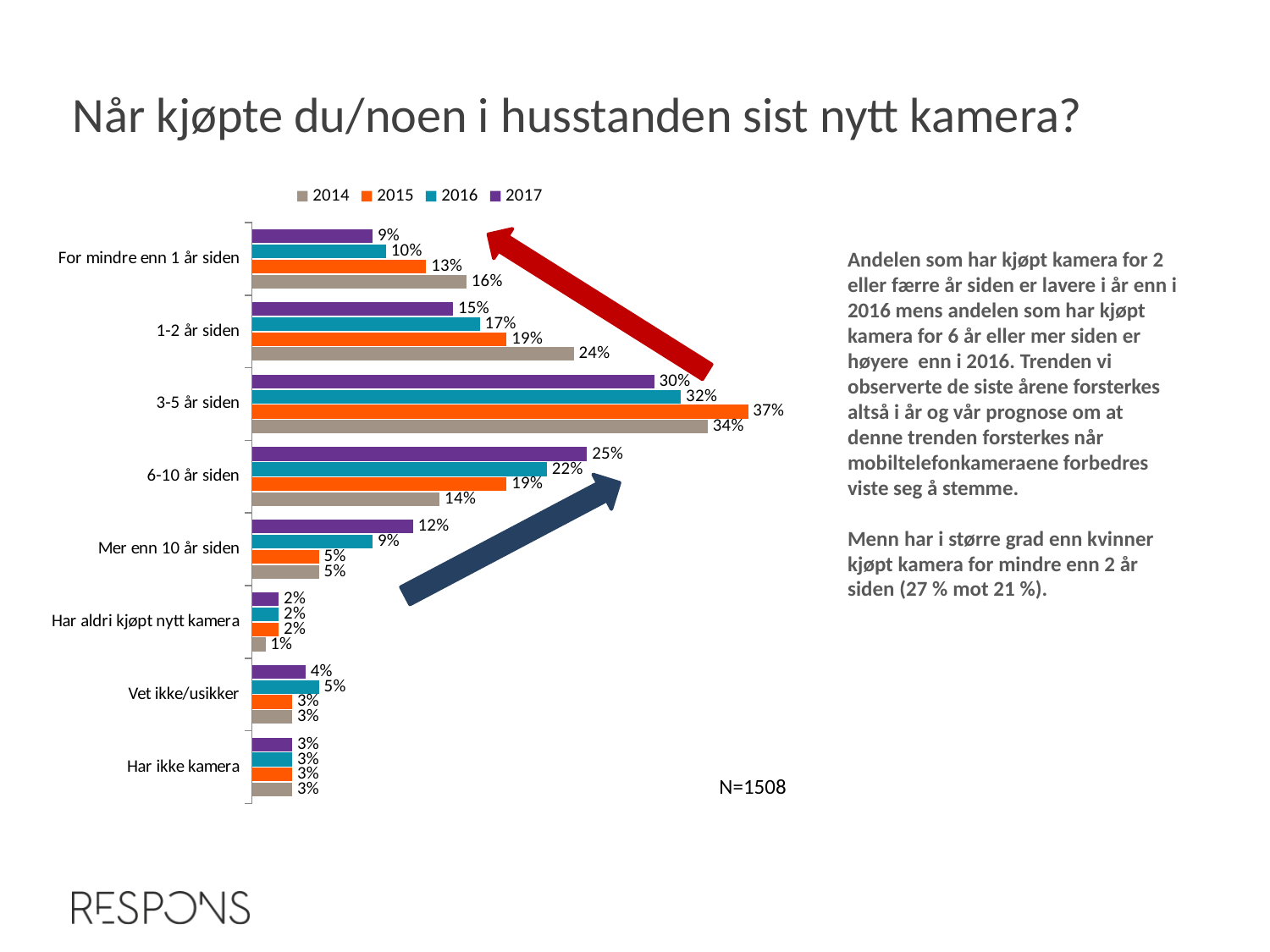
For "Mer enn 10 år siden", which is larger: the 2017 value or the 2016 value? 2017 What is the sample size (N) shown on the slide? N=1508 How many categories are shown on the chart? 8 What is the title of the chart on the slide? Når kjøpte du/noen i husstanden sist nytt kamera? What kind of chart is shown on the slide? Bar chart What is the difference between the 2014 and 2017 values for "For mindre enn 1 år siden"? 7% Which category has the lowest 2014 value? Har aldri kjøpt nytt kamera What is the 2017 value for "3-5 år siden"? 30% Which category has the highest 2015 value? 3-5 år siden What is the 2016 value for "6-10 år siden"? 22% What is the 2014 value for "1-2 år siden"? 24% How many series does the legend list? 4